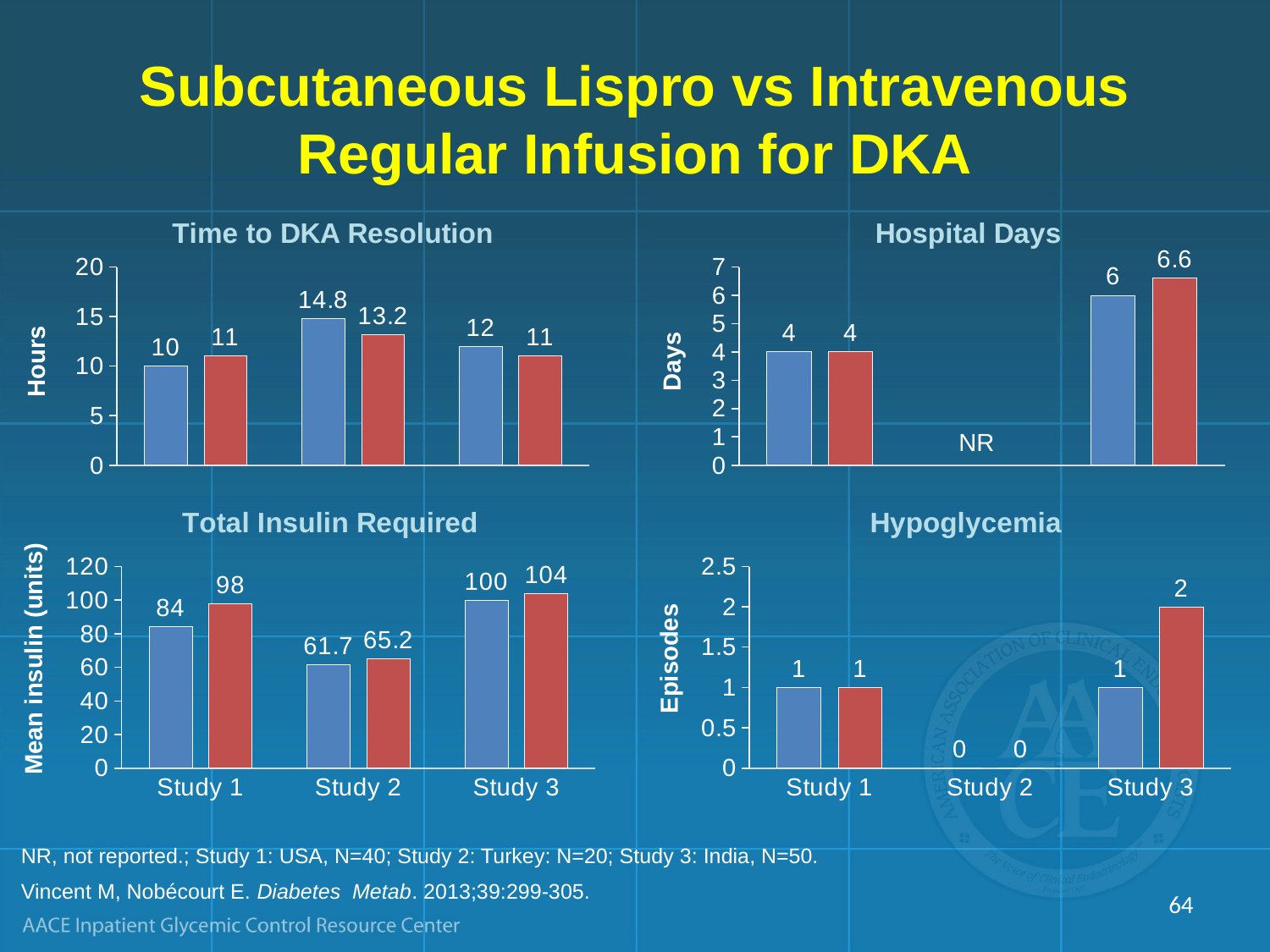
What type of chart is the Total Insulin Required chart? Bar chart In the Hypoglycemia chart, which study has the highest red bar? Study 3 In the Hospital Days chart, what is the value of the red bar in the rightmost pair? 6.6 In the Time to DKA Resolution chart, what is the value of the blue bar in the middle pair of bars? 14.8 In the Time to DKA Resolution chart, what is the difference between the blue and red bars in the middle pair? 1.6 In the Hypoglycemia chart, what is the value of the red bar for Study 3? 2 In the Total Insulin Required chart, what is the difference between the red and blue bars for Study 1? 14 In the Total Insulin Required chart, what is the value of the red bar for Study 1? 98 How many studies are shown on the x axis of the Hypoglycemia chart? 3 In the Time to DKA Resolution chart, what is the value of the red bar in the middle pair of bars? 13.2 In the Total Insulin Required chart, which study has the lowest blue bar? Study 2 In the Hospital Days chart, what is shown for the middle study instead of bars? NR